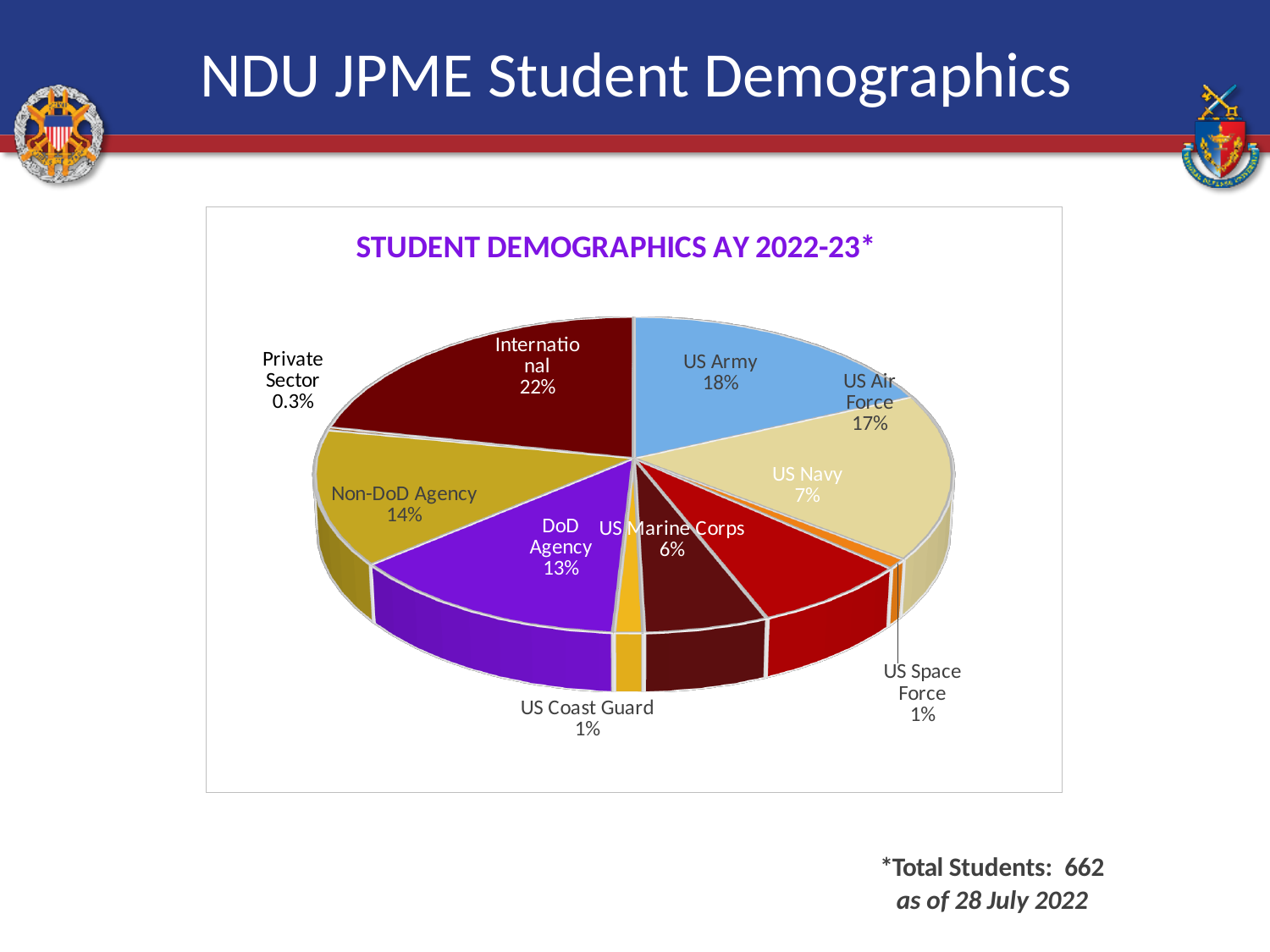
What share of students is US Navy? 7% Which category has the smallest share of students? Private Sector What share of students is Non-DoD Agency? 14% What is the title of the chart? STUDENT DEMOGRAPHICS AY 2022-23* What share of students is International? 22% What kind of chart is shown on the slide? Pie chart What is the difference in percentage points between US Army and US Air Force? 1% Which is larger, the DoD Agency share or the US Marine Corps share? DoD Agency How many categories are shown in the pie chart? 10 Which category has the largest share of students? International